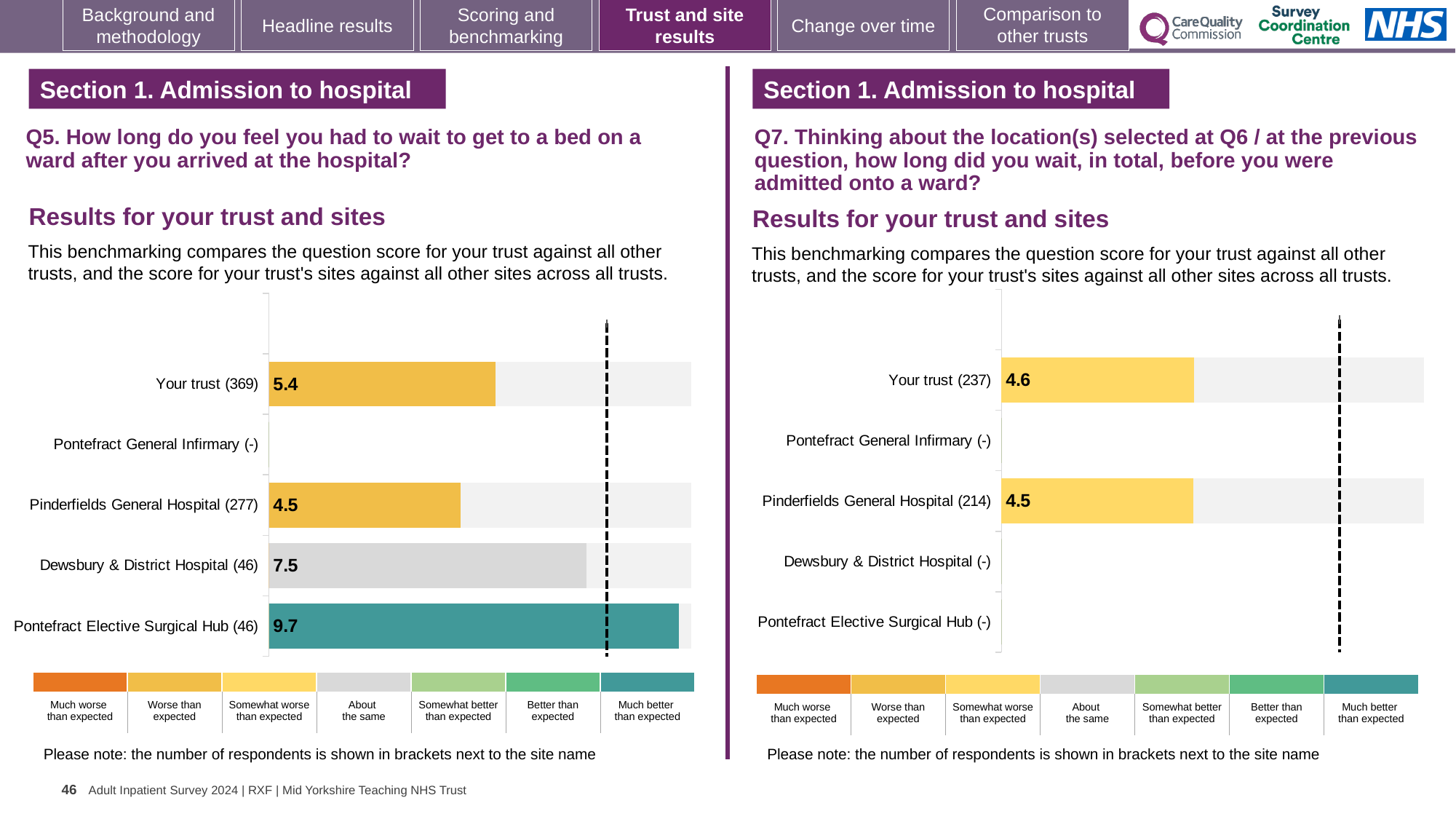
On the Q5 chart (left), what is the score for Your trust (369)? 5.4 On the Q7 chart (right), what is the score for Pinderfields General Hospital (214)? 4.5 On the Q5 chart (left), what is the score for Dewsbury & District Hospital (46)? 7.5 On the Q7 chart (right), how many sites have no plotted score (shown with a dash)? 3 On the Q5 chart (left), what is the difference between the scores for Pontefract Elective Surgical Hub (46) and Pinderfields General Hospital (277)? 5.2 On the Q5 chart (left), which site with a plotted score has the lowest score? Pinderfields General Hospital (277) On the Q5 chart (left), what is the score for Pontefract Elective Surgical Hub (46)? 9.7 On the Q5 chart (left), which has the larger score, Dewsbury & District Hospital (46) or Your trust (369)? Dewsbury & District Hospital (46) On the Q5 chart (left), which site has the highest score? Pontefract Elective Surgical Hub (46) What kind of chart is used on the Q5 chart (left)? Bar chart On the Q7 chart (right), what is the score for Your trust (237)? 4.6 On the Q7 chart (right), what is the difference between the scores for Your trust (237) and Pinderfields General Hospital (214)? 0.1